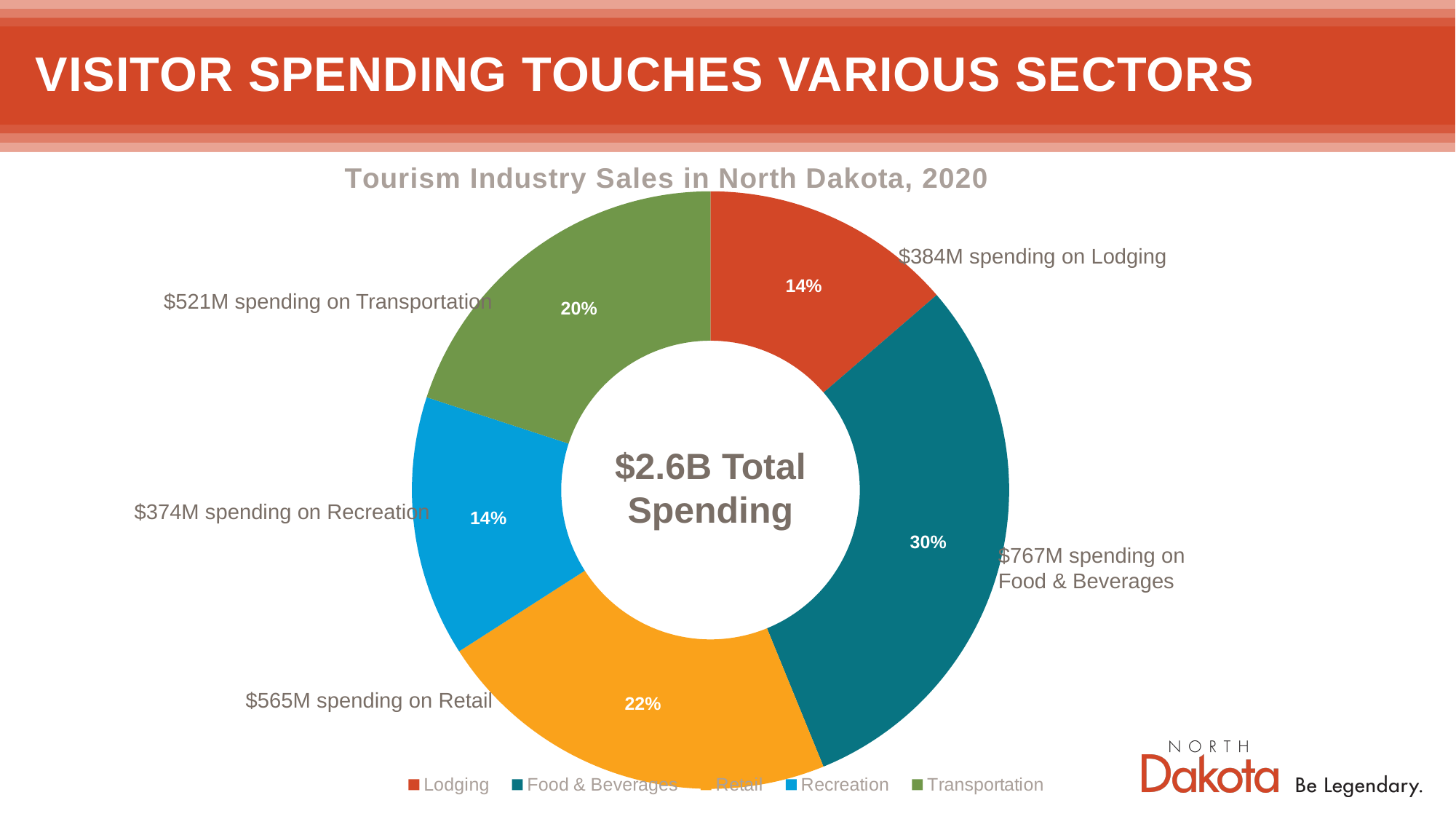
What is the difference in spending between Food & Beverages and Retail? $202M How much visitor spending went to Retail? $565M Which sector has the lowest dollar spending? Recreation What is the total spending shown in the centre of the chart? $2.6B Total Spending Which has higher spending, Retail or Transportation? Retail Which sector has the largest share of spending? Food & Beverages What percentage share of spending does Food & Beverages account for? 30% How much visitor spending went to Transportation? $521M What percentage share of spending does Lodging account for? 14% How many sectors are shown in the chart? 5 What kind of chart is shown on the slide? Doughnut (pie) chart What is the title of the chart? Tourism Industry Sales in North Dakota, 2020